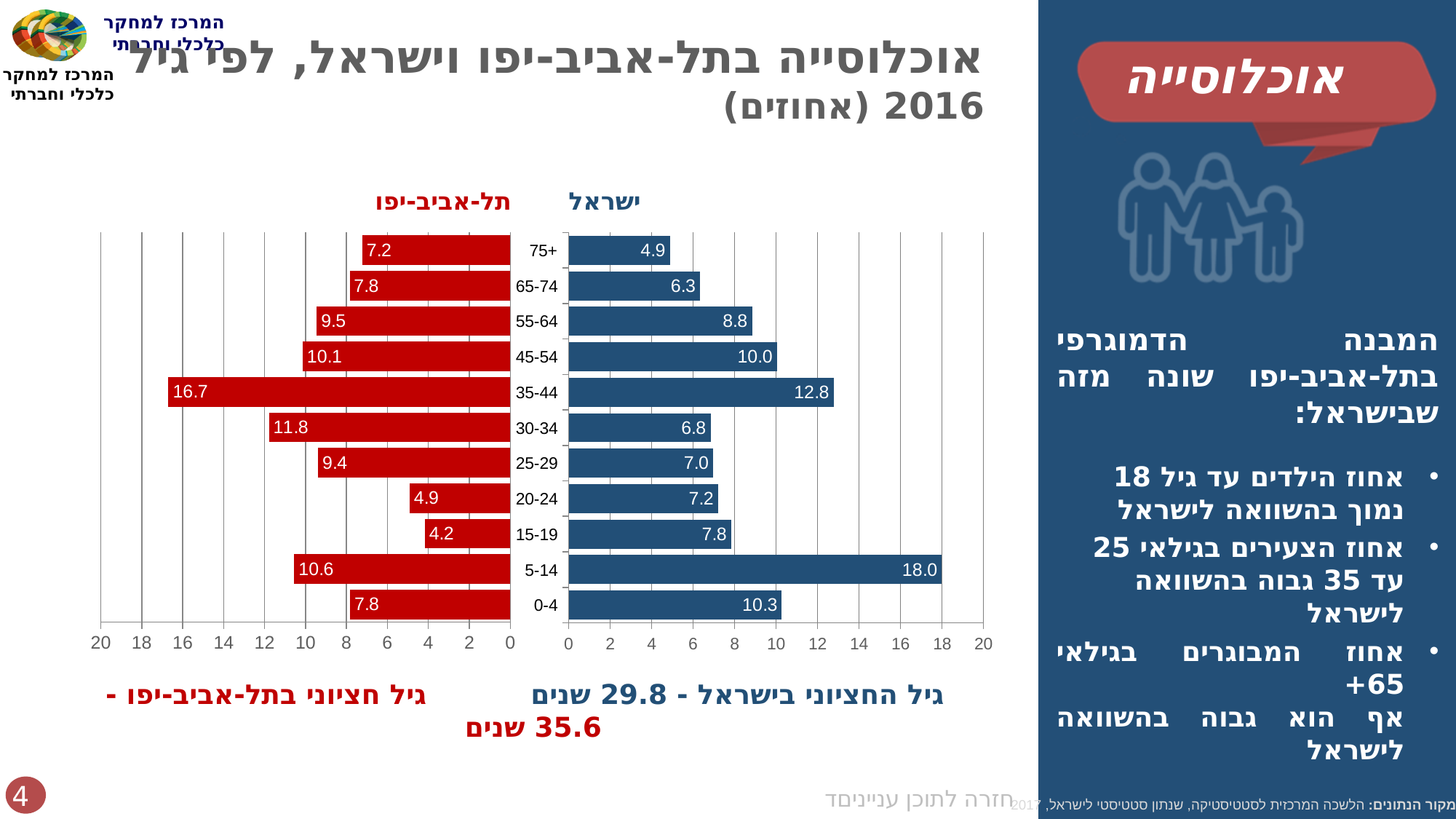
Which age group has the highest value in the Tel Aviv-Yafo (תל-אביב-יפו) series? 35-44 What is the value for the 5-14 age group in the Israel (ישראל) series? 18.0 How many age groups are shown on the chart? 11 How many series does the chart show? 2 What is the difference between the Tel Aviv-Yafo and Israel values for the 35-44 age group? 3.9 What colour are the bars for the Tel Aviv-Yafo (תל-אביב-יפו) series? Red Which age group has the lowest value in the Israel (ישראל) series? 75+ What is the value for the 15-19 age group in the Tel Aviv-Yafo (תל-אביב-יפו) series? 4.2 What is the value for the 35-44 age group in the Tel Aviv-Yafo (תל-אביב-יפו) series? 16.7 What is the value for the 75+ age group in the Israel (ישראל) series? 4.9 What kind of chart is shown on the slide? Bar chart For the 5-14 age group, which series has the larger value, Tel Aviv-Yafo or Israel? Israel (ישראל)